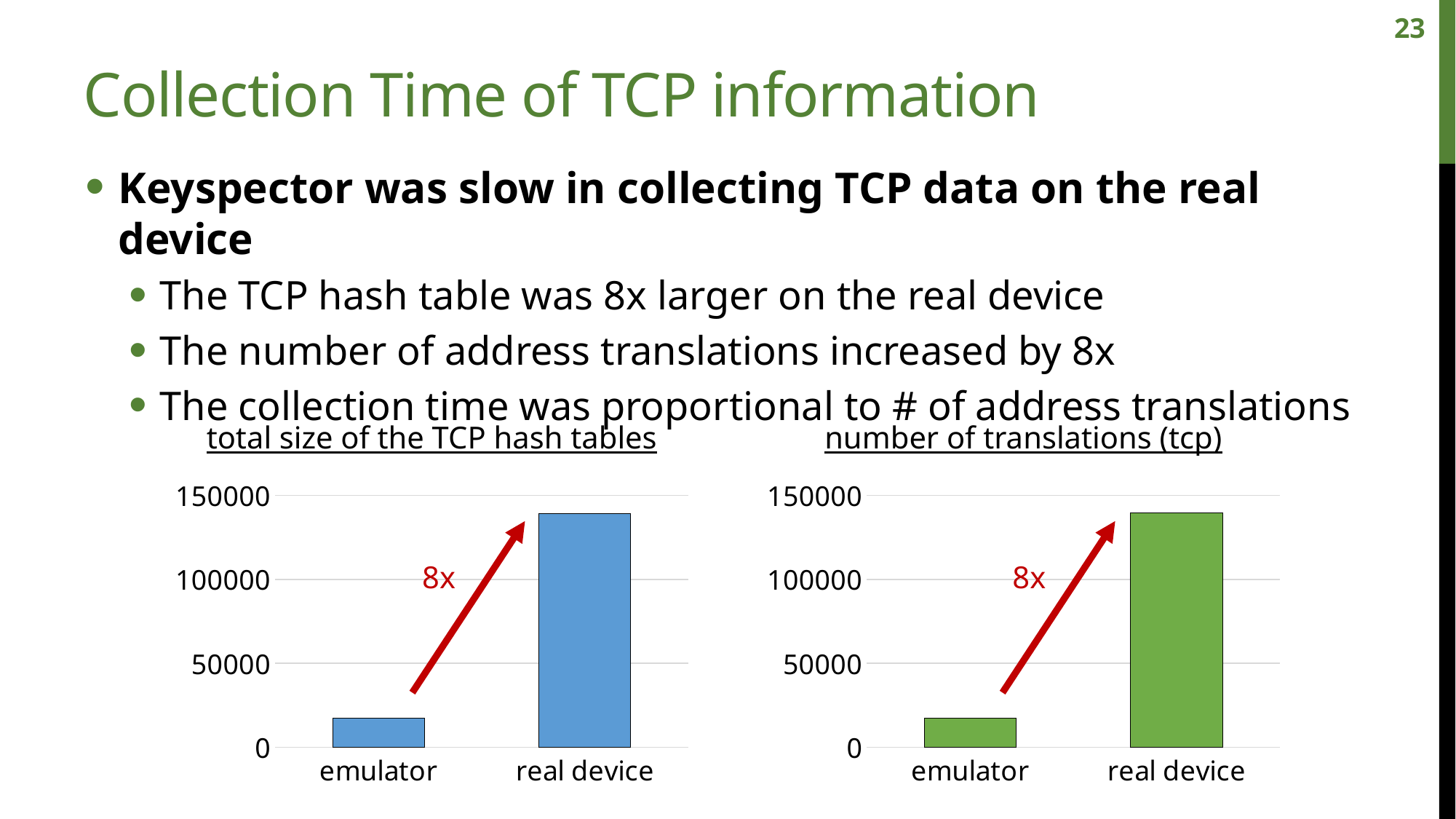
In the 'total size of the TCP hash tables' chart, is the value for emulator greater or less than 50000? less In the 'number of translations (tcp)' chart, is the value for emulator greater or less than 50000? less In the 'total size of the TCP hash tables' chart, is the value for real device greater or less than 100000? greater In the 'total size of the TCP hash tables' chart, which category has the higher value? real device How many categories are shown in the 'total size of the TCP hash tables' chart? 2 In the 'number of translations (tcp)' chart, is the value for emulator larger or smaller than the value for real device? smaller In the 'number of translations (tcp)' chart, which category has the higher value? real device What kind of chart is the 'number of translations (tcp)' chart? bar chart What colour are the bars in the 'number of translations (tcp)' chart? green What factor of increase is annotated by the red arrow in the 'total size of the TCP hash tables' chart? 8x In the 'total size of the TCP hash tables' chart, which category has the lowest value? emulator